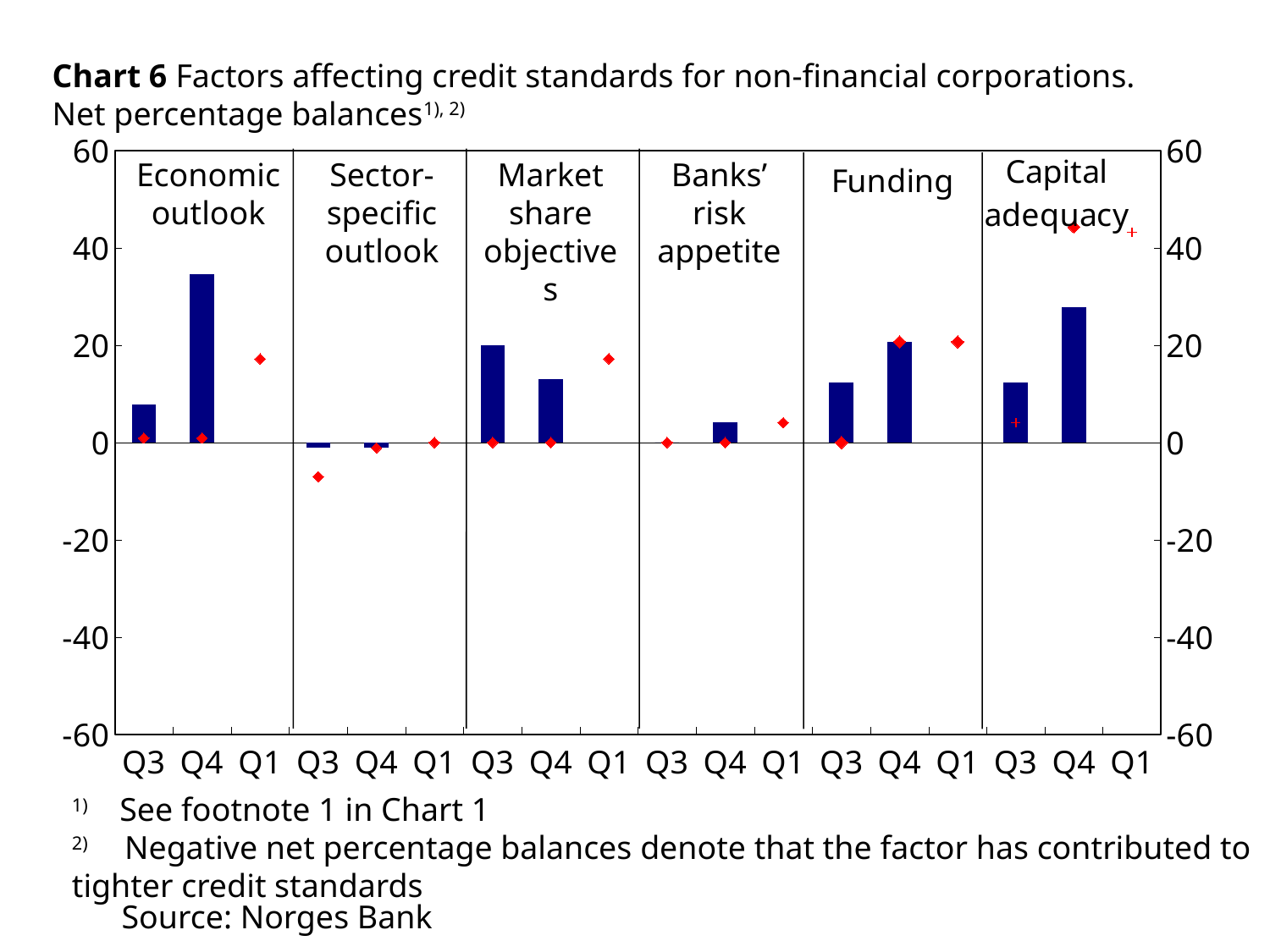
Is the Q1 marker for Capital adequacy greater or less than 40? greater Which quarters are shown on the x axis within each panel of Chart 6? Q3, Q4, Q1 Which factor is the only one with negative bars in Chart 6? Sector-specific outlook Which factor has the highest Q4 bar in Chart 6? Economic outlook Is the Q4 bar for Capital adequacy greater or less than 20? greater What kind of chart is Chart 6? bar chart How many factors (panels) are shown in Chart 6? 6 For Economic outlook, which bar is larger, Q3 or Q4? Q4 What is the source given for Chart 6? Norges Bank For Market share objectives, which bar is larger, Q3 or Q4? Q3 Is the Q4 bar for Economic outlook greater or less than 20? greater